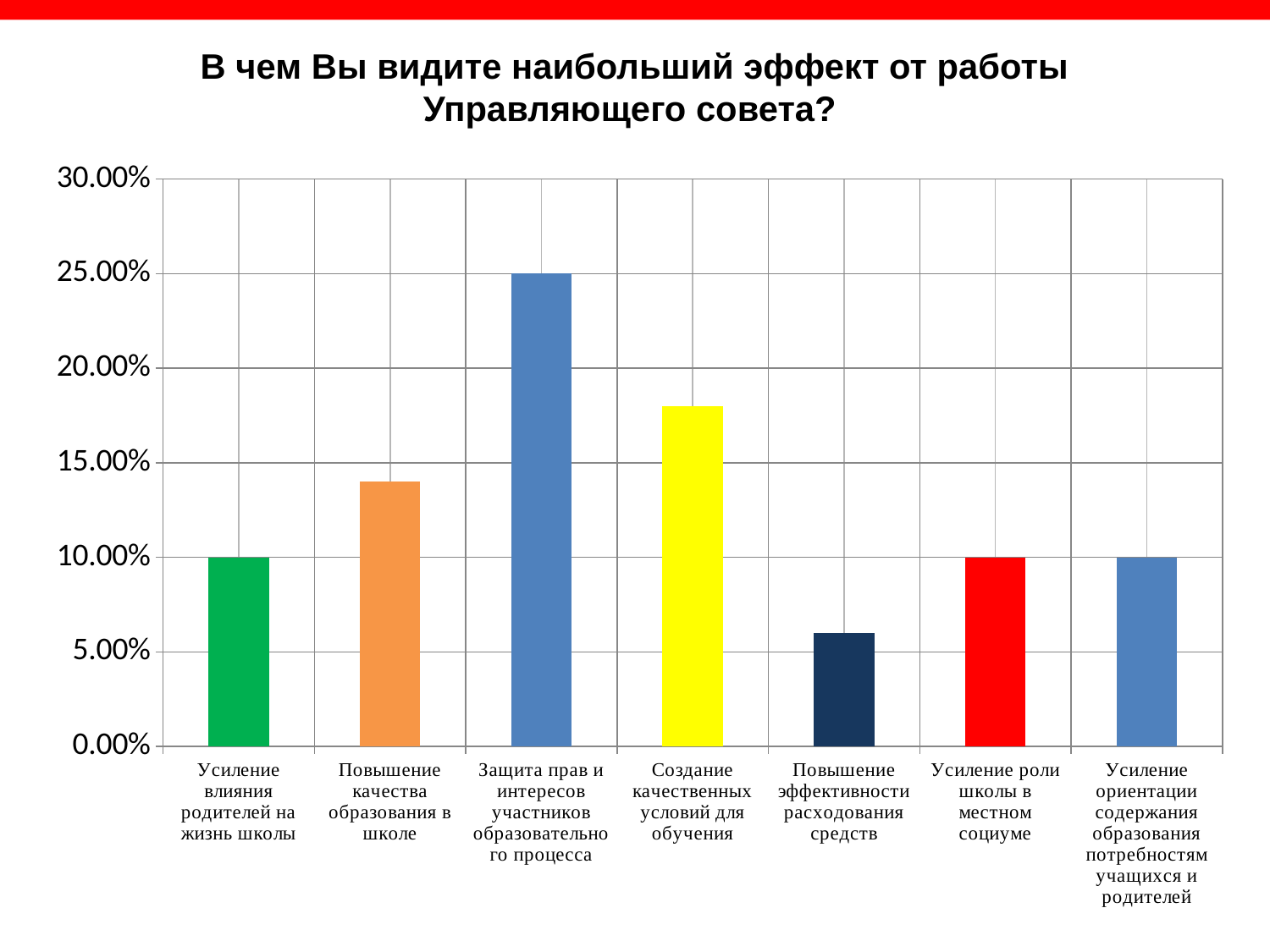
Which category has the lowest value in the chart? Повышение эффективности расходования средств Is the value for 'Повышение эффективности расходования средств' greater or less than 10.00%? less What is the value for 'Усиление влияния родителей на жизнь школы'? 10.00% Is the value for 'Повышение качества образования в школе' greater or less than 15.00%? less What kind of chart is shown on the slide? bar chart What is the title of the chart on the slide? В чем Вы видите наибольший эффект от работы Управляющего совета? Which category has the highest value in the chart? Защита прав и интересов участников образовательного процесса How many categories are shown on the x axis of the chart? 7 Which is larger: the value for 'Защита прав и интересов участников образовательного процесса' or for 'Создание качественных условий для обучения'? Защита прав и интересов участников образовательного процесса What is the value for 'Защита прав и интересов участников образовательного процесса'? 25.00% Is the value for 'Создание качественных условий для обучения' greater or less than 15.00%? greater What is the difference between the value for 'Защита прав и интересов участников образовательного процесса' and the value for 'Усиление роли школы в местном социуме'? 15.00%